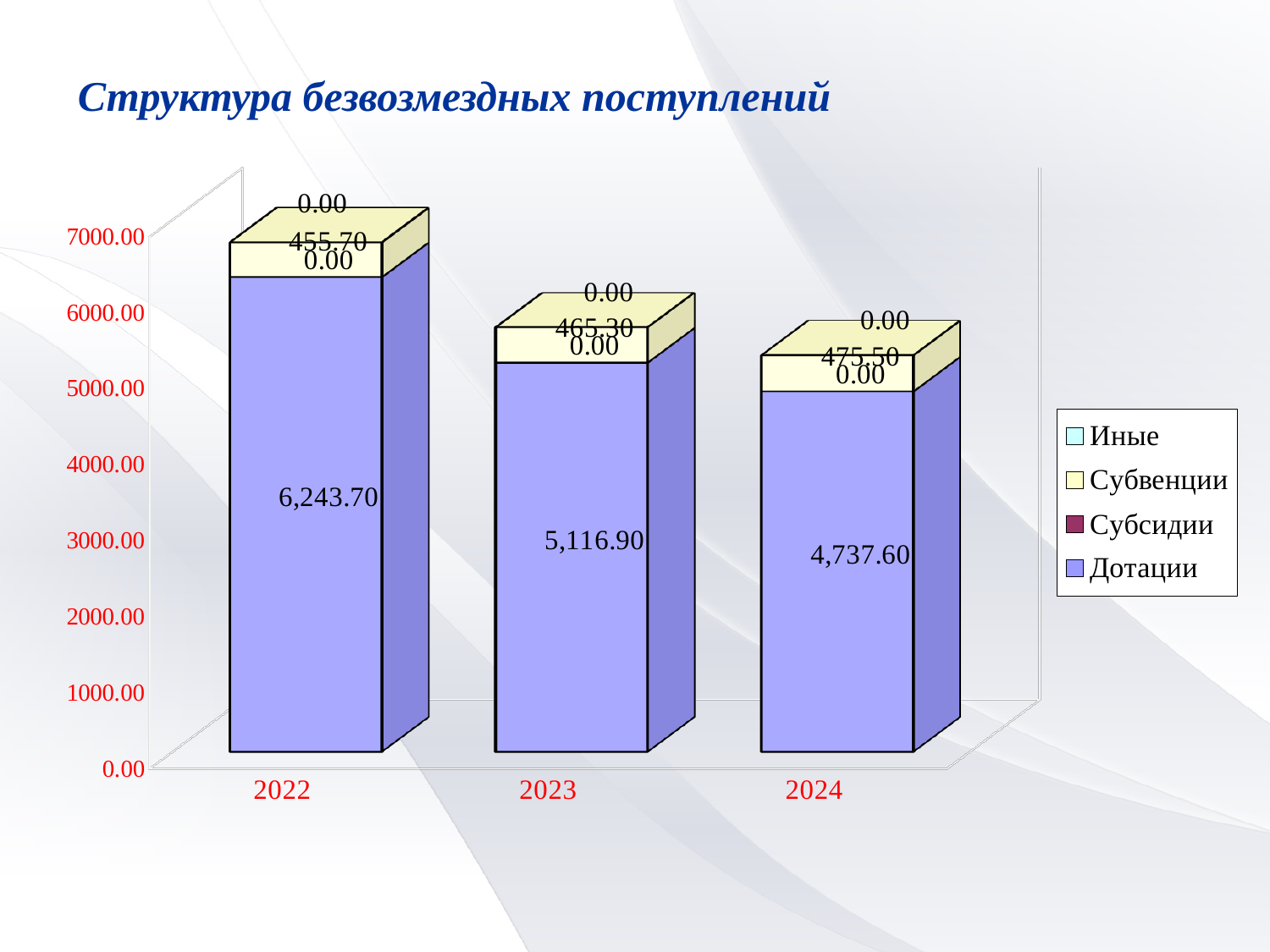
What kind of chart is shown on the slide? Stacked bar chart What is the value of Дотации for 2022? 6,243.70 What is the difference between the Дотации values for 2022 and 2023? 1,126.80 What is the value of Дотации for 2023? 5,116.90 Which is larger: Дотации in 2023 or Дотации in 2024? Дотации in 2023 Which year has the lowest value of Субвенции? 2022 What is the value of Субвенции for 2024? 475.50 Do the Дотации values rise or fall from 2022 to 2024? Fall What is the total of the stacked bar for 2024? 5,213.10 How many years are shown on the x axis? 3 How many series does the legend list? 4 Which year has the highest value of Дотации? 2022